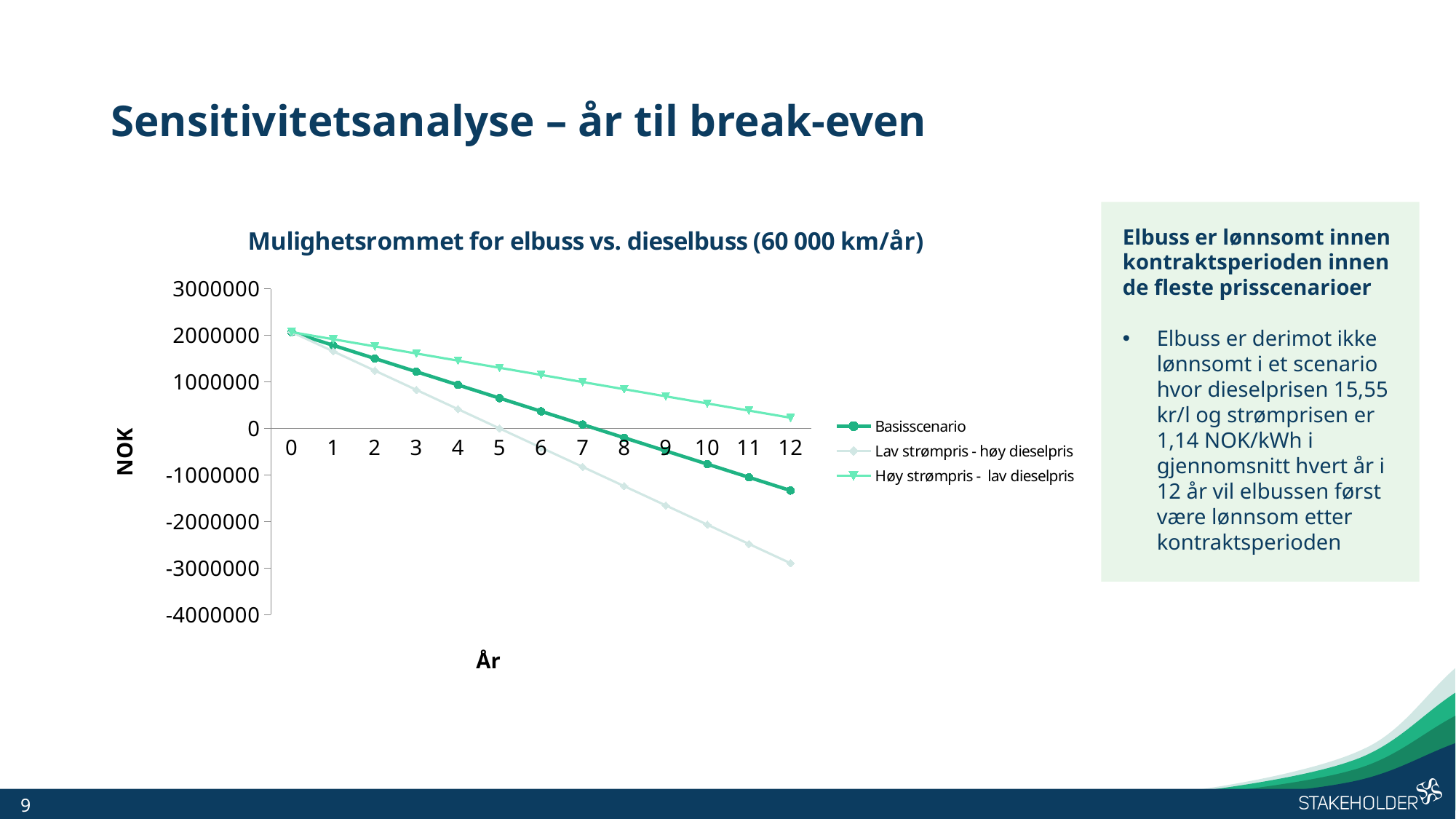
How many series does the legend list? 3 At year 12, which is higher: Basisscenario or Lav strømpris - høy dieselpris? Basisscenario How many points (years) are plotted along the x axis? 13 Is the value for Høy strømpris - lav dieselpris at year 12 greater or less than 0? greater What is the title of the chart? Mulighetsrommet for elbuss vs. dieselbuss (60 000 km/år) Do the values for Basisscenario rise or fall as the year increases? fall Which series has the highest value at year 12? Høy strømpris - lav dieselpris Is the value for Lav strømpris - høy dieselpris at year 12 greater or less than -2000000? less Which series has the lowest value at year 12? Lav strømpris - høy dieselpris Is the value for Basisscenario at year 12 greater or less than -1000000? less What kind of chart is shown on the slide? line chart What is the label on the y axis of the chart? NOK